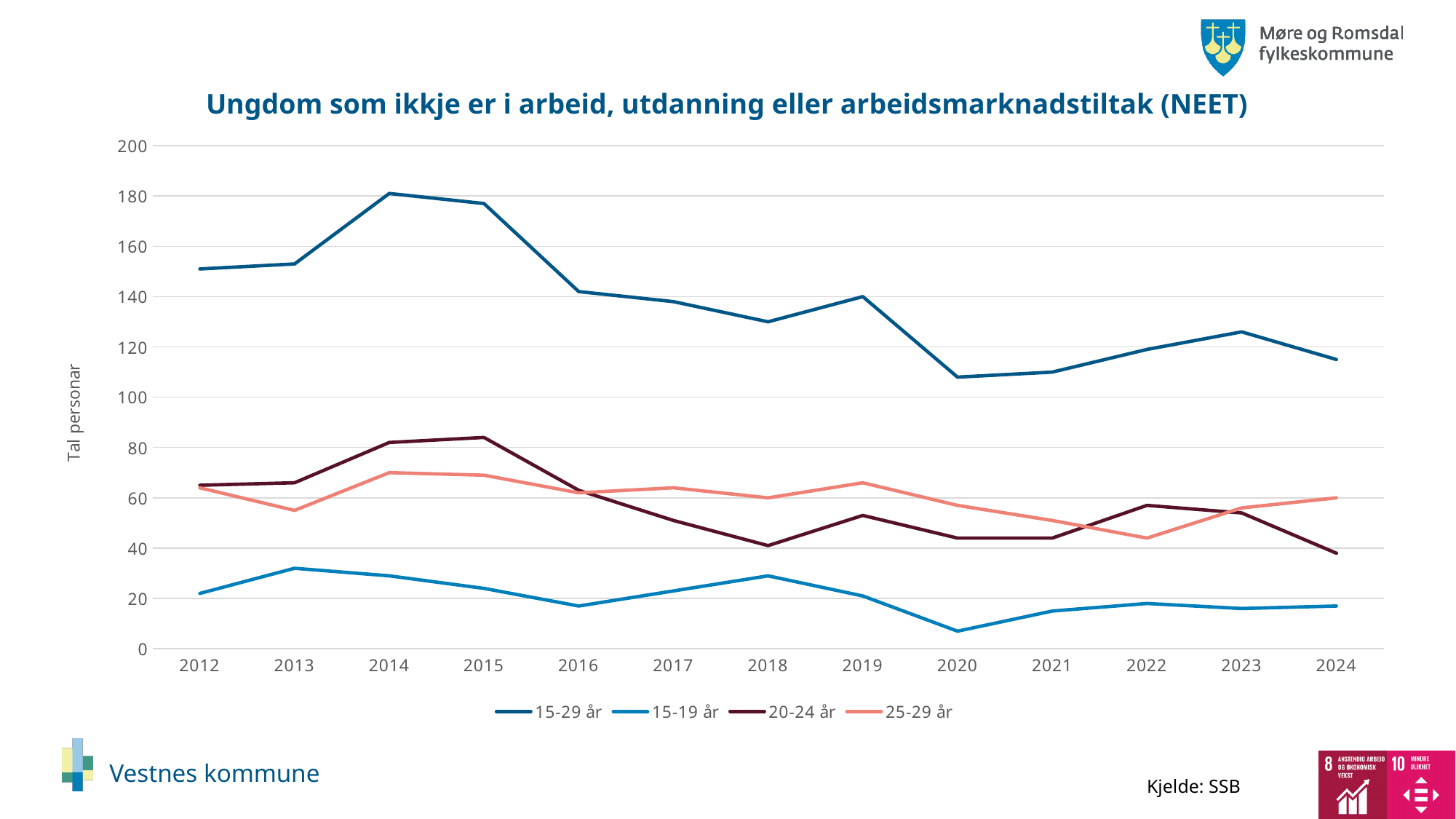
Is the value for 15-29 år in 2020 greater or less than 120? less In which year does the 15-29 år series reach its lowest value? 2020 How many years are shown on the x axis? 13 Does the 15-29 år series rise or fall from 2015 to 2016? fall In which year does the 15-29 år series reach its highest value? 2014 Is the value for 15-29 år in 2014 greater or less than 160? greater What kind of chart is shown on the slide? line chart Is the value for 15-19 år in 2013 greater or less than 20? greater In 2024, which series has the larger value: 25-29 år or 20-24 år? 25-29 år In which year does the 20-24 år series reach its highest value? 2015 How many series does the legend list? 4 In which year does the 15-19 år series reach its lowest value? 2020